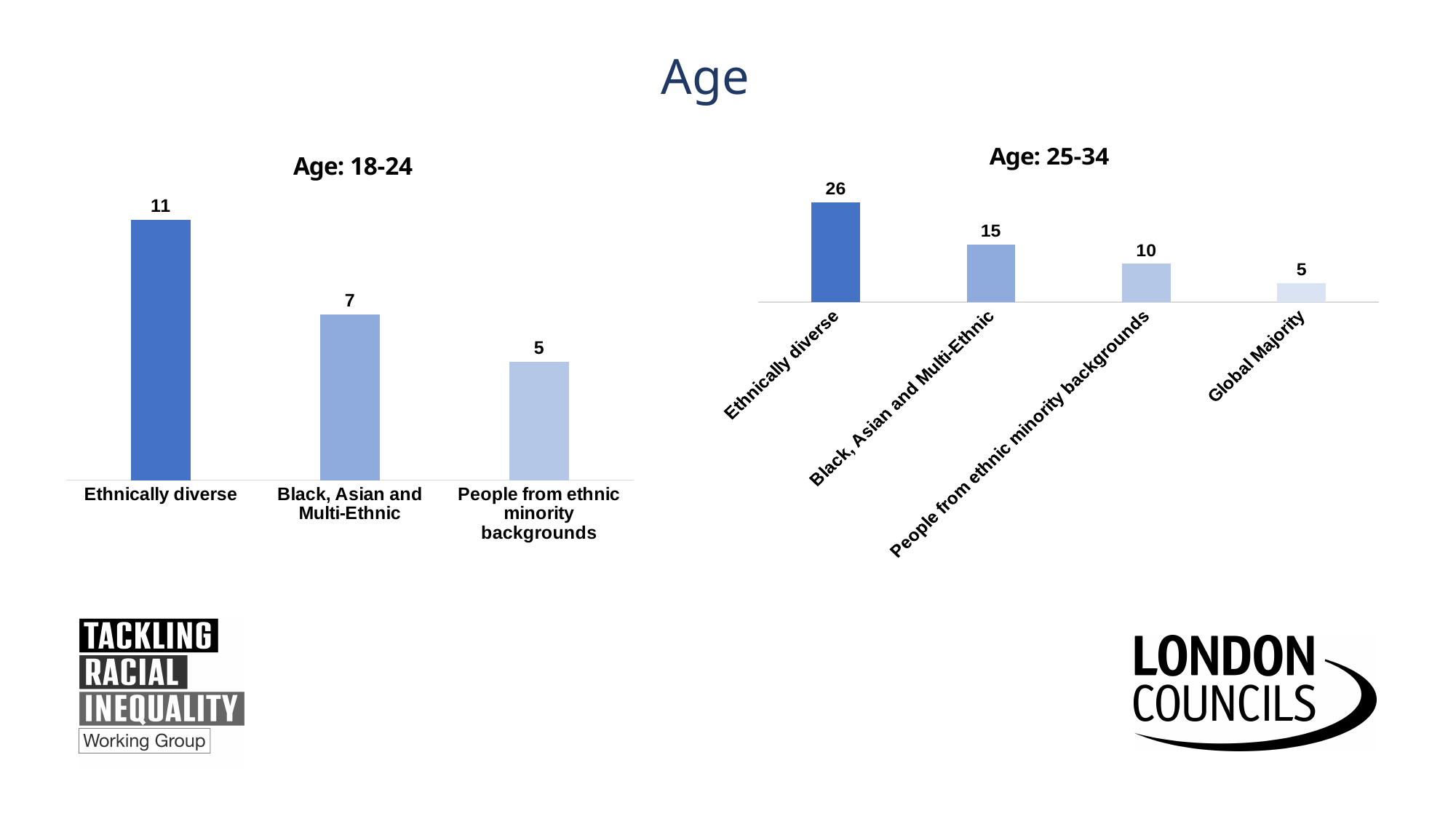
In the 'Age: 25-34' chart, what is the value for Black, Asian and Multi-Ethnic? 15 In the 'Age: 25-34' chart, what is the value for Global Majority? 5 In the 'Age: 18-24' chart, which category has the lowest value? People from ethnic minority backgrounds How many categories are shown in the 'Age: 25-34' chart? 4 In the 'Age: 25-34' chart, which category has the highest value? Ethnically diverse How many categories are shown in the 'Age: 18-24' chart? 3 In the 'Age: 18-24' chart, what is the difference between Ethnically diverse and People from ethnic minority backgrounds? 6 In the 'Age: 18-24' chart, what is the value for Black, Asian and Multi-Ethnic? 7 In the 'Age: 25-34' chart, what is the difference between Ethnically diverse and People from ethnic minority backgrounds? 16 In the 'Age: 25-34' chart, do the values rise or fall from left to right? fall In the 'Age: 18-24' chart, what is the value for Ethnically diverse? 11 What type of chart is the 'Age: 18-24' chart? bar chart